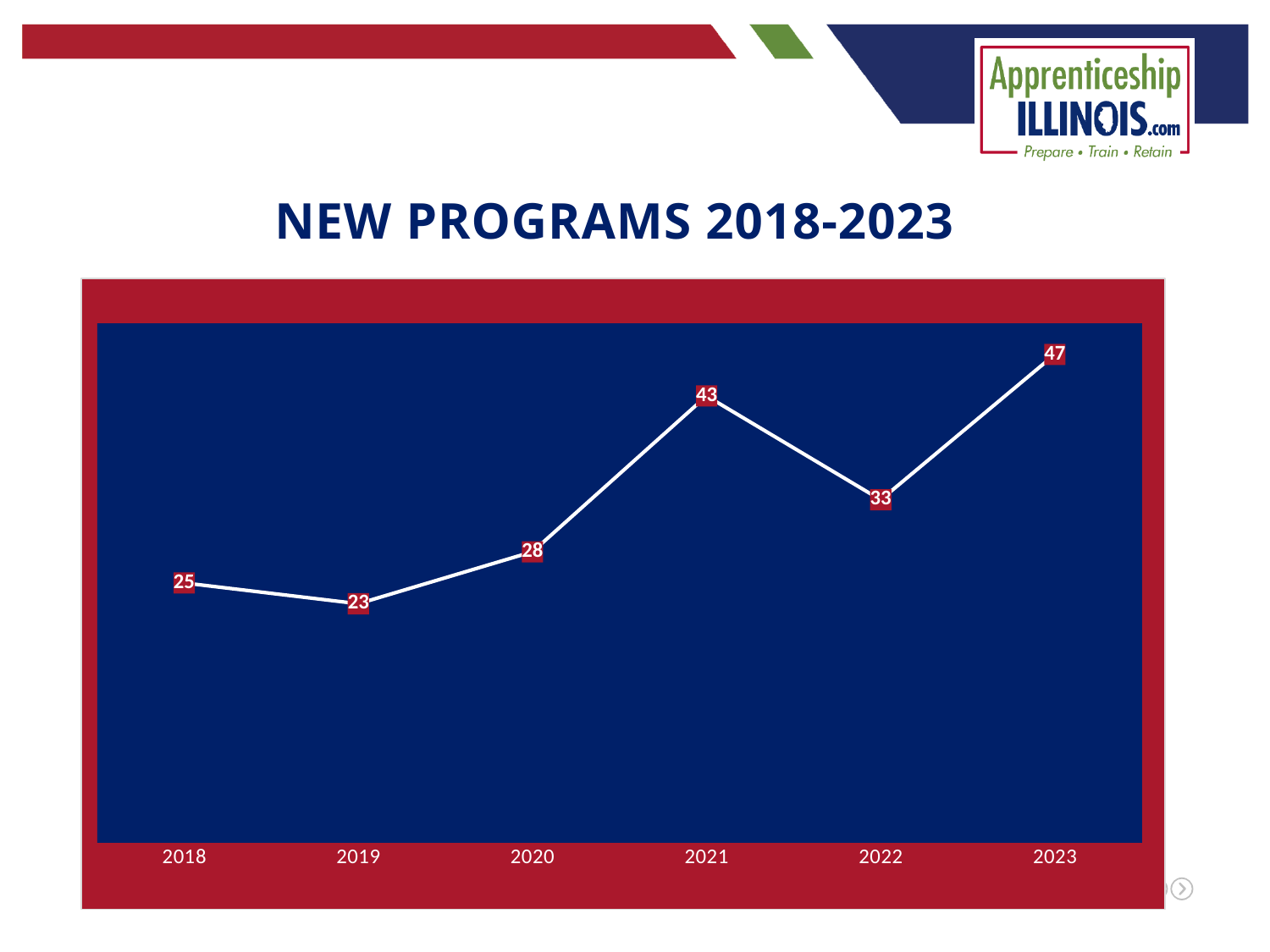
How many years are plotted on the chart? 6 What is the value for 2022? 33 What kind of chart is shown? line chart Which year has the lowest value? 2019 Which year has the highest value? 2023 What is the value for 2018? 25 Which is larger, the value for 2020 or the value for 2019? 2020 What is the difference between the values for 2021 and 2022? 10 What is the title of the chart? NEW PROGRAMS 2018-2023 What is the difference between the values for 2023 and 2018? 22 What is the value for 2021? 43 Does the value rise or fall from 2021 to 2022? fall